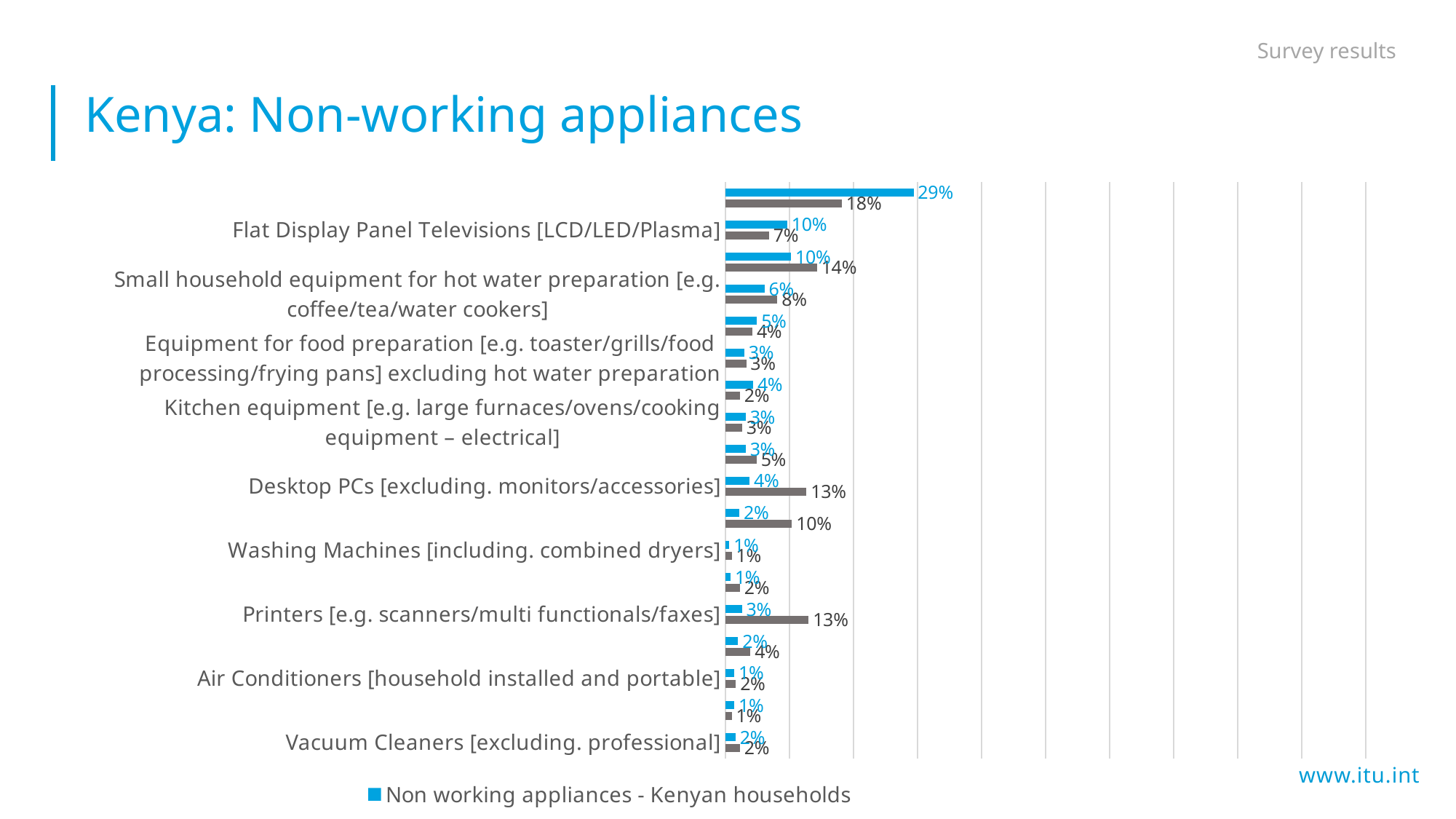
Which has the larger blue bar value: Desktop PCs or Printers? Desktop PCs What is the title of the slide's chart? Kenya: Non-working appliances What is the value of the blue bar for Desktop PCs [excluding. monitors/accessories]? 4% What is the value of the grey bar for Desktop PCs [excluding. monitors/accessories]? 13% What is the legend entry shown for the blue bars? Non working appliances - Kenyan households What is the difference between the blue bar values for Flat Display Panel Televisions and Desktop PCs? 6 percentage points What type of chart is shown on the slide? bar chart What is the value of the blue bar for Flat Display Panel Televisions [LCD/LED/Plasma]? 10% What is the value of the blue bar for Printers [e.g. scanners/multi functionals/faxes]? 3% What is the highest value shown for the blue series on the chart? 29% What is the value of the blue bar for Washing Machines [including. combined dryers]? 1% How many entries does the chart legend list? 1